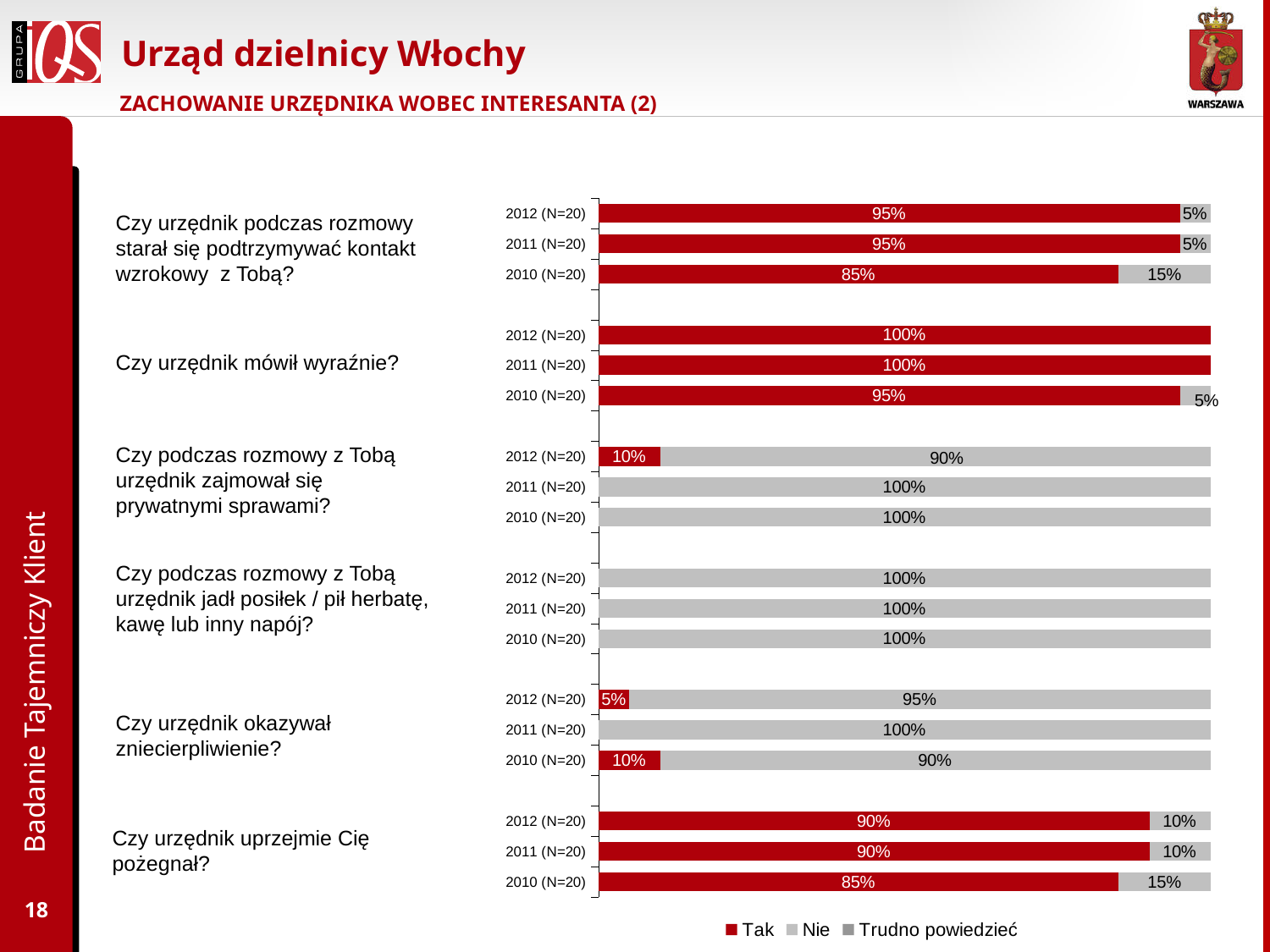
What kind of chart is shown on the slide? Stacked bar chart For "Czy urzędnik okazywał zniecierpliwienie?", which is larger: the "Tak" share in 2012 (N=20) or in 2010 (N=20)? 2010 (N=20) What percentage of respondents answered "Tak" in 2012 (N=20) to "Czy urzędnik podczas rozmowy starał się podtrzymywać kontakt wzrokowy z Tobą?"? 95% How many survey questions are shown on the chart? 6 What percentage answered "Tak" in 2012 (N=20) to "Czy podczas rozmowy z Tobą urzędnik zajmował się prywatnymi sprawami?"? 10% For "Czy urzędnik podczas rozmowy starał się podtrzymywać kontakt wzrokowy z Tobą?", which year had the lowest "Tak" share? 2010 (N=20) What percentage answered "Tak" in 2010 (N=20) to "Czy urzędnik okazywał zniecierpliwienie?"? 10% Which legend entry is shown in red? Tak For "Czy urzędnik uprzejmie Cię pożegnał?", what is the difference between the "Tak" share in 2012 (N=20) and in 2010 (N=20)? 5% What percentage answered "Tak" in 2010 (N=20) to "Czy urzędnik mówił wyraźnie?"? 95% What percentage answered "Nie" in 2010 (N=20) to "Czy urzędnik podczas rozmowy starał się podtrzymywać kontakt wzrokowy z Tobą?"? 15% How many series does the legend list? 3